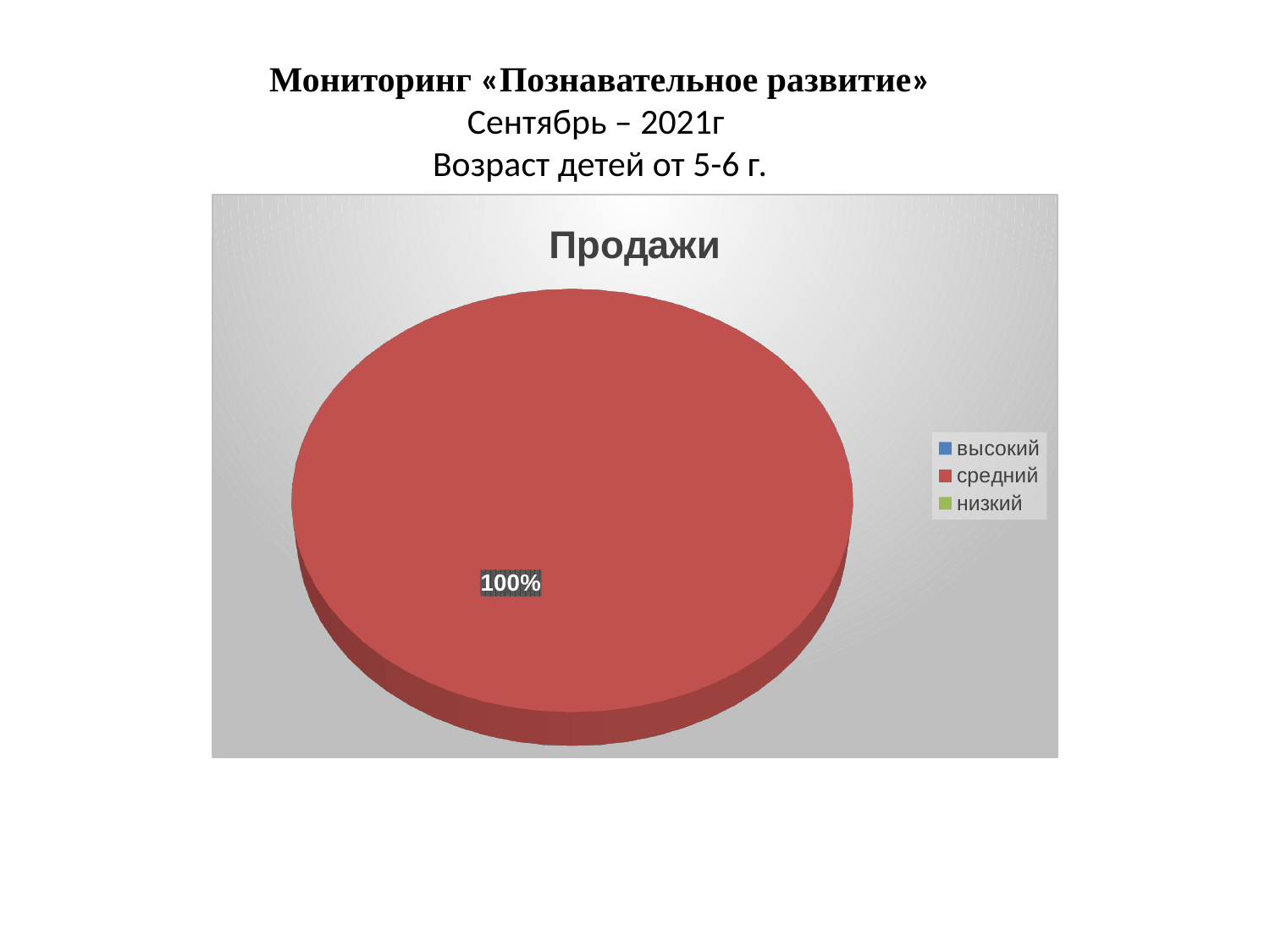
What kind of chart is shown on the slide? pie chart Which category has the largest share of the pie? средний How many categories does the chart legend list? 3 Is the share for средний greater or less than 50%? greater Which is larger, the share for средний or the share for высокий? средний What percentage is shown for the средний slice? 100% Which is larger, the share for средний or the share for низкий? средний What colour is the средний slice? red How many slices are visible in the pie? 1 What is the title of the chart? Продажи What share of the pie does the средний category take? 100%